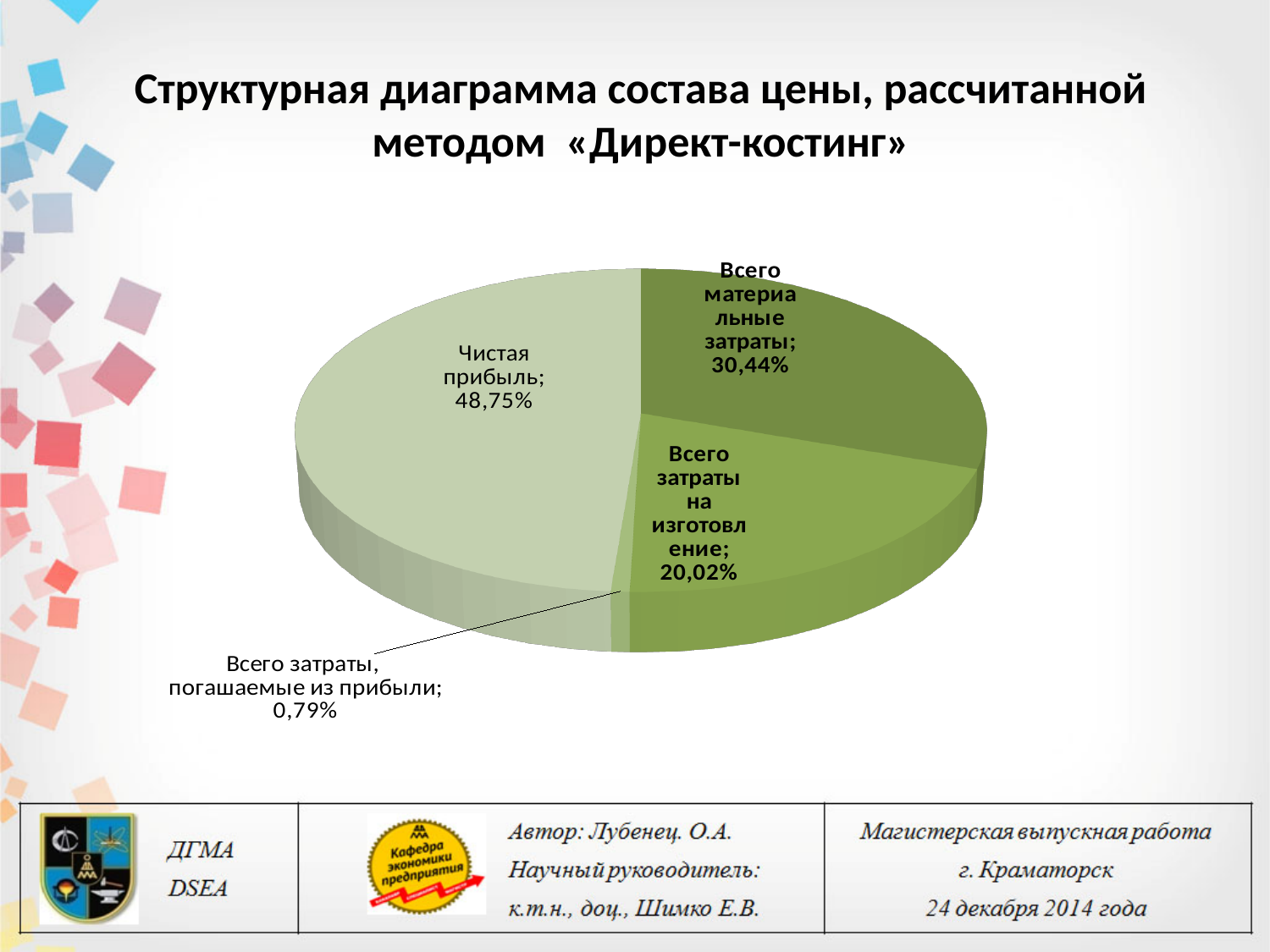
What is the value shown for "Всего затраты, погашаемые из прибыли"? 0,79% What is the value shown for "Всего материальные затраты"? 30,44% What is the title of the chart on the slide? Структурная диаграмма состава цены, рассчитанной методом «Директ-костинг» What is the difference between the shares of "Всего материальные затраты" and "Всего затраты на изготовление"? 10,42% How many slices does the pie chart have? 4 What kind of chart is shown on the slide? pie chart What is the value shown for "Всего затраты на изготовление"? 20,02% Which is larger: "Всего материальные затраты" or "Всего затраты на изготовление"? Всего материальные затраты Which slice of the pie is the largest? Чистая прибыль What is the difference between the shares of "Чистая прибыль" and "Всего материальные затраты"? 18,31% Which slice of the pie is the smallest? Всего затраты, погашаемые из прибыли What share of the pie does "Чистая прибыль" have? 48,75%